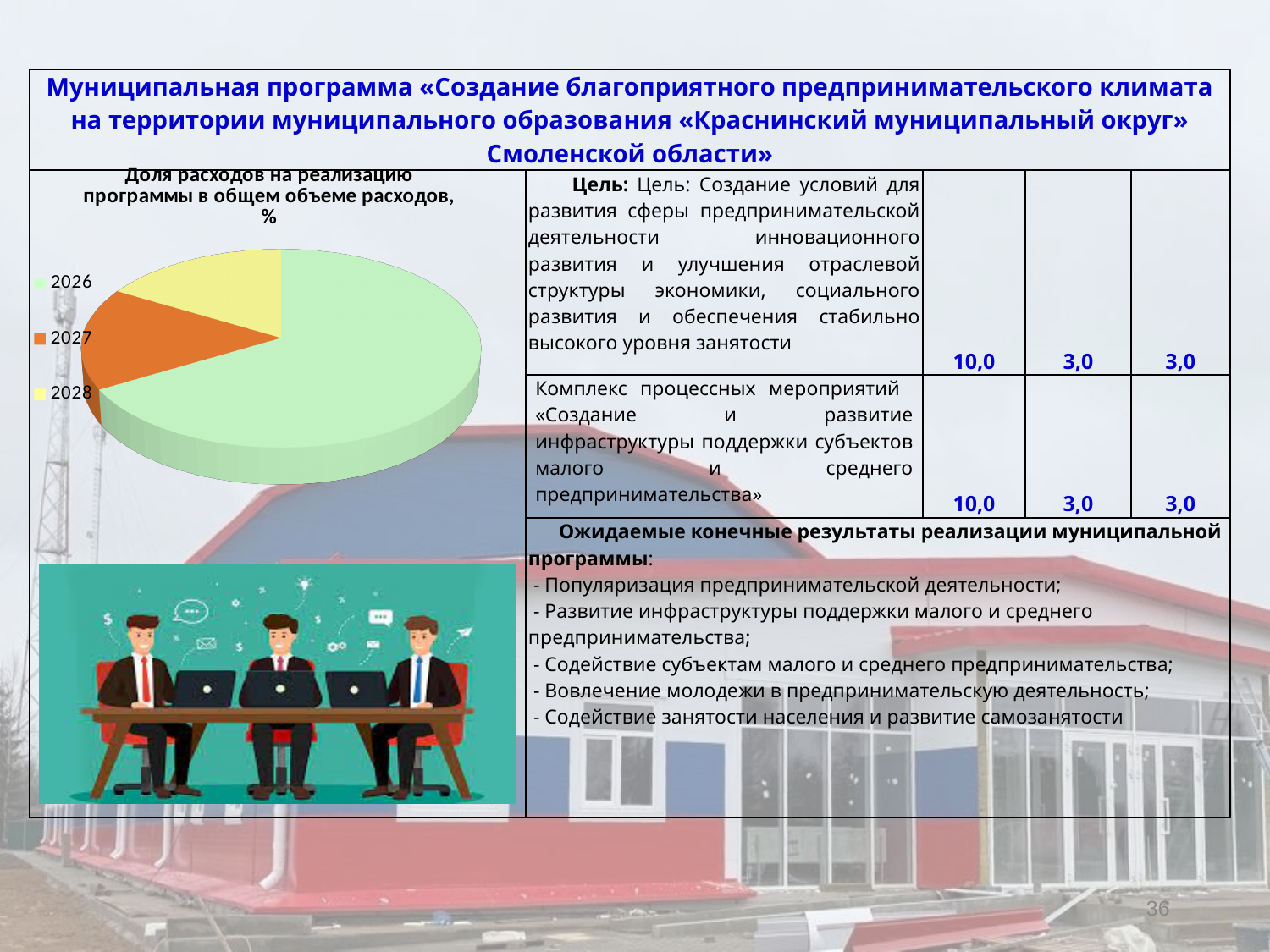
How many slices does the pie chart have? 3 What kind of chart is shown on the slide? pie chart How many entries does the legend of the pie chart list? 3 Which year is shown in green in the pie chart? 2026 Which slice is larger in the pie chart, 2026 or 2028? 2026 What is the title of the pie chart? Доля расходов на реализацию программы в общем объеме расходов, % Which slice is larger in the pie chart, 2026 or 2027? 2026 Which year has the largest slice in the pie chart? 2026